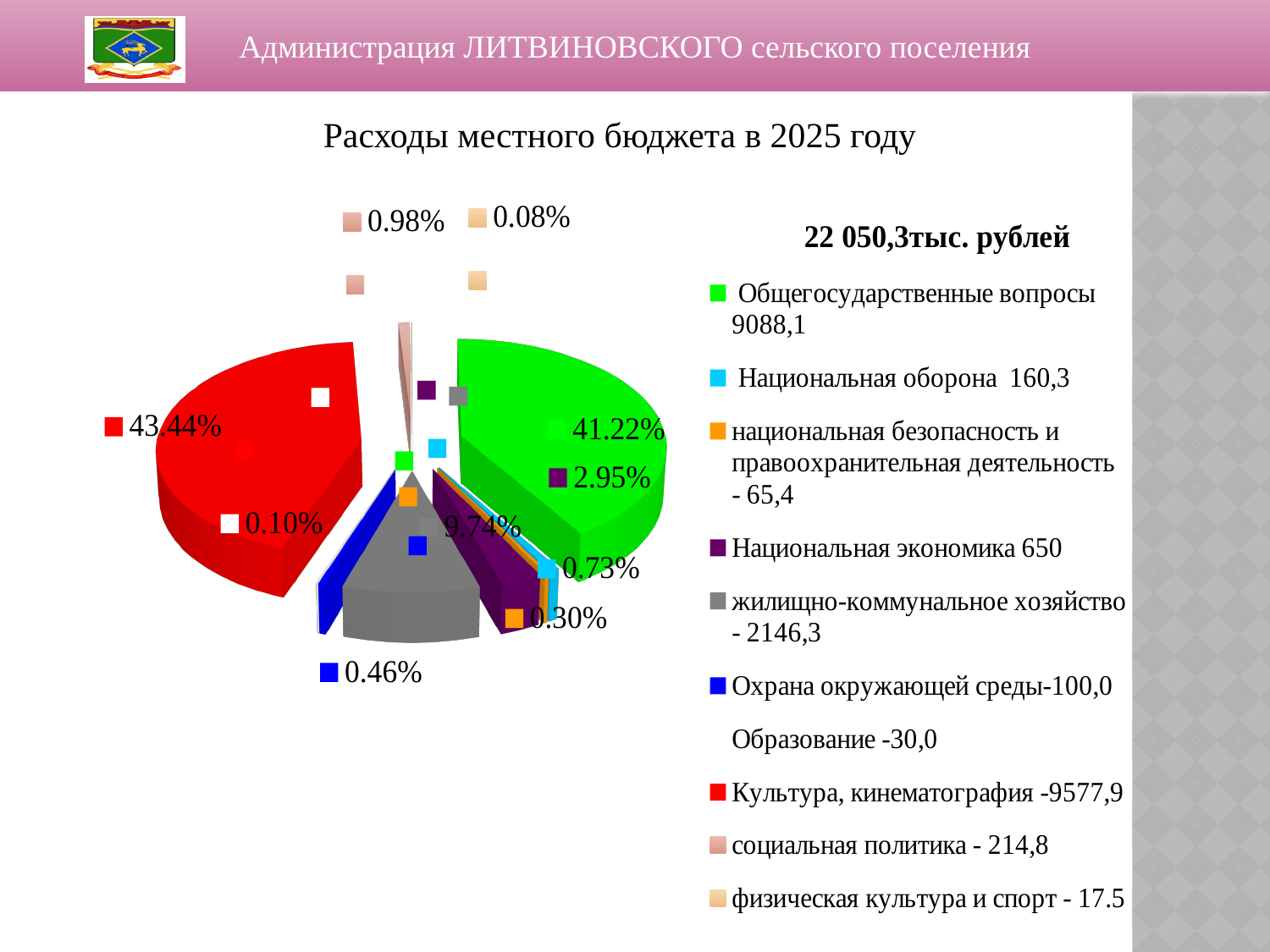
How many categories does the legend list? 10 What share of the pie does жилищно-коммунальное хозяйство have? 9.74% Which category has the smallest share of the pie? физическая культура и спорт What amount in thousand rubles is given for Культура, кинематография in the legend? 9577,9 What share of the pie does социальная политика have? 0.98% What is the title of the chart? Расходы местного бюджета в 2025 году What share of the pie does Национальная экономика have? 2.95% Which category has the largest share of the pie? Культура, кинематография What is the difference in percentage points between the shares of Культура, кинематография and Общегосударственные вопросы? 2.22 What kind of chart is shown on the slide? Pie chart Which has the larger share: Национальная оборона or Охрана окружающей среды? Национальная оборона